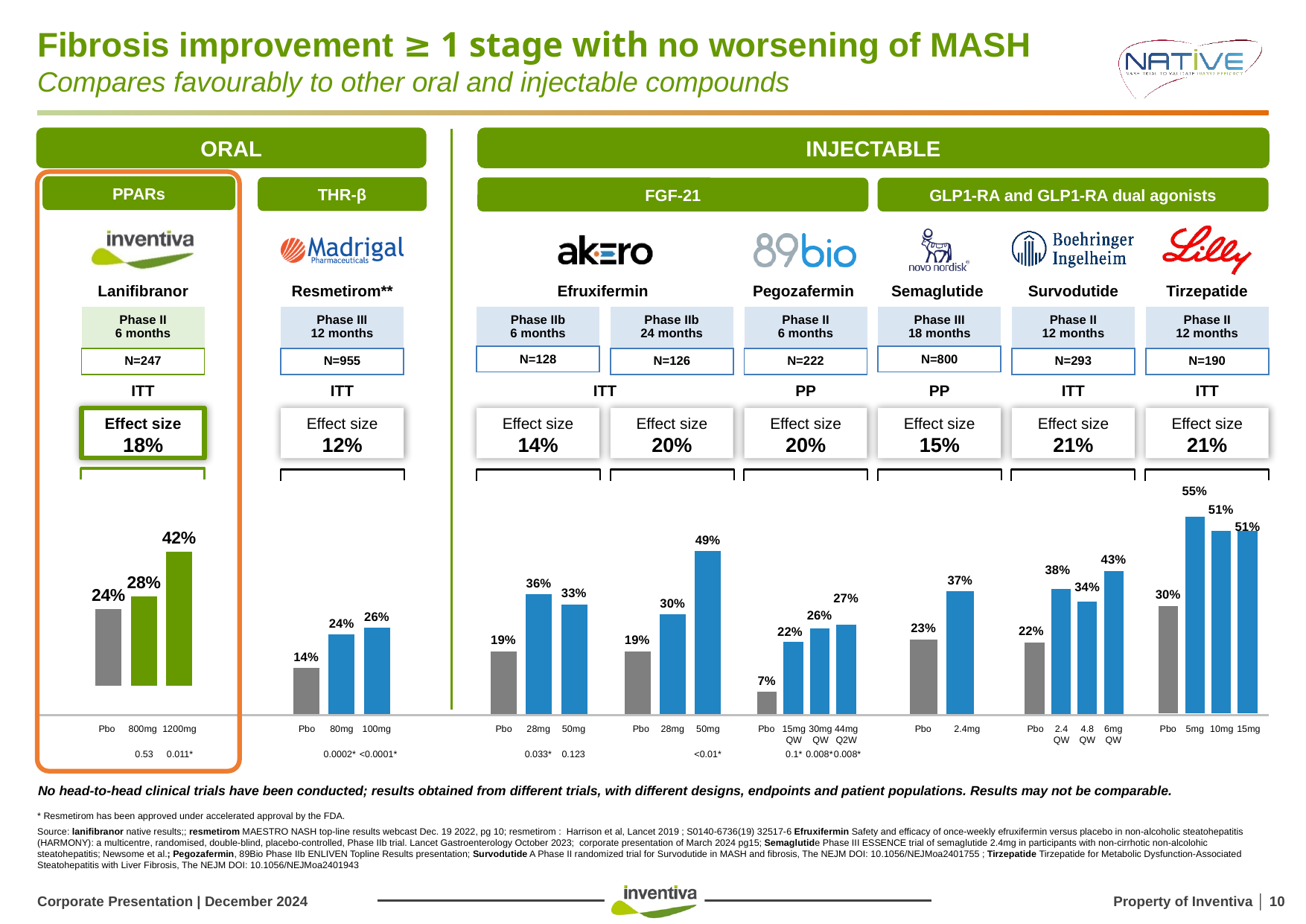
How many bars are in the Pegozafermin chart? 4 In the Semaglutide chart, what is the difference between the 2.4mg bar and the Pbo bar? 14% What kind of chart is used to show the Tirzepatide results? Bar chart In the Lanifibranor chart, what is the value for the 1200mg bar? 42% In the Efruxifermin Phase IIb 6 months chart, which is larger, the 28mg bar or the 50mg bar? 28mg In the Lanifibranor chart, what is the difference between the 1200mg bar and the Pbo bar? 18% In the Survodutide chart, which dose has the highest value? 6mg QW In the Pegozafermin chart, what is the value for the Pbo bar? 7% In the Efruxifermin Phase IIb 24 months chart, which dose has the highest value? 50mg What effect size is shown for Resmetirom? 12% In the Resmetirom chart, what is the value for the Pbo bar? 14% In the Tirzepatide chart, what is the value for the 5mg bar? 55%